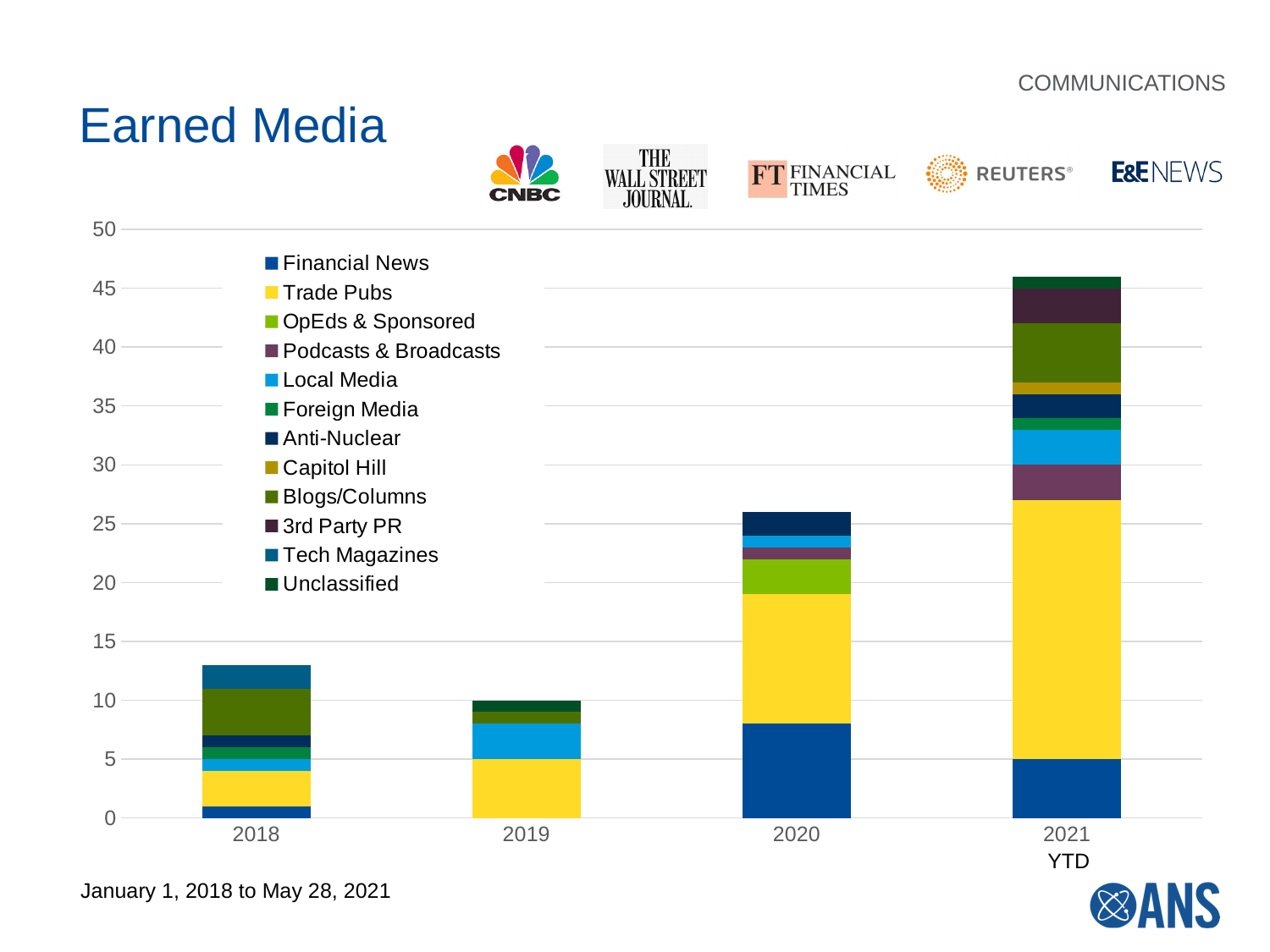
Which year has the tallest stacked bar? 2021 YTD What date range is stated below the chart? January 1, 2018 to May 28, 2021 Is the total for 2021 YTD greater or less than 40? greater Do the bar totals rise or fall from 2019 to 2021 YTD? rise How many series does the legend list? 12 Which bar is taller, 2020 or 2018? 2020 What is the title of the chart? Earned Media Which year has the shortest stacked bar? 2019 Is the total for 2020 greater or less than 20? greater What kind of chart is shown on the slide? Stacked bar chart How many year categories are shown on the x axis? 4 Is the total for 2018 greater or less than 15? less